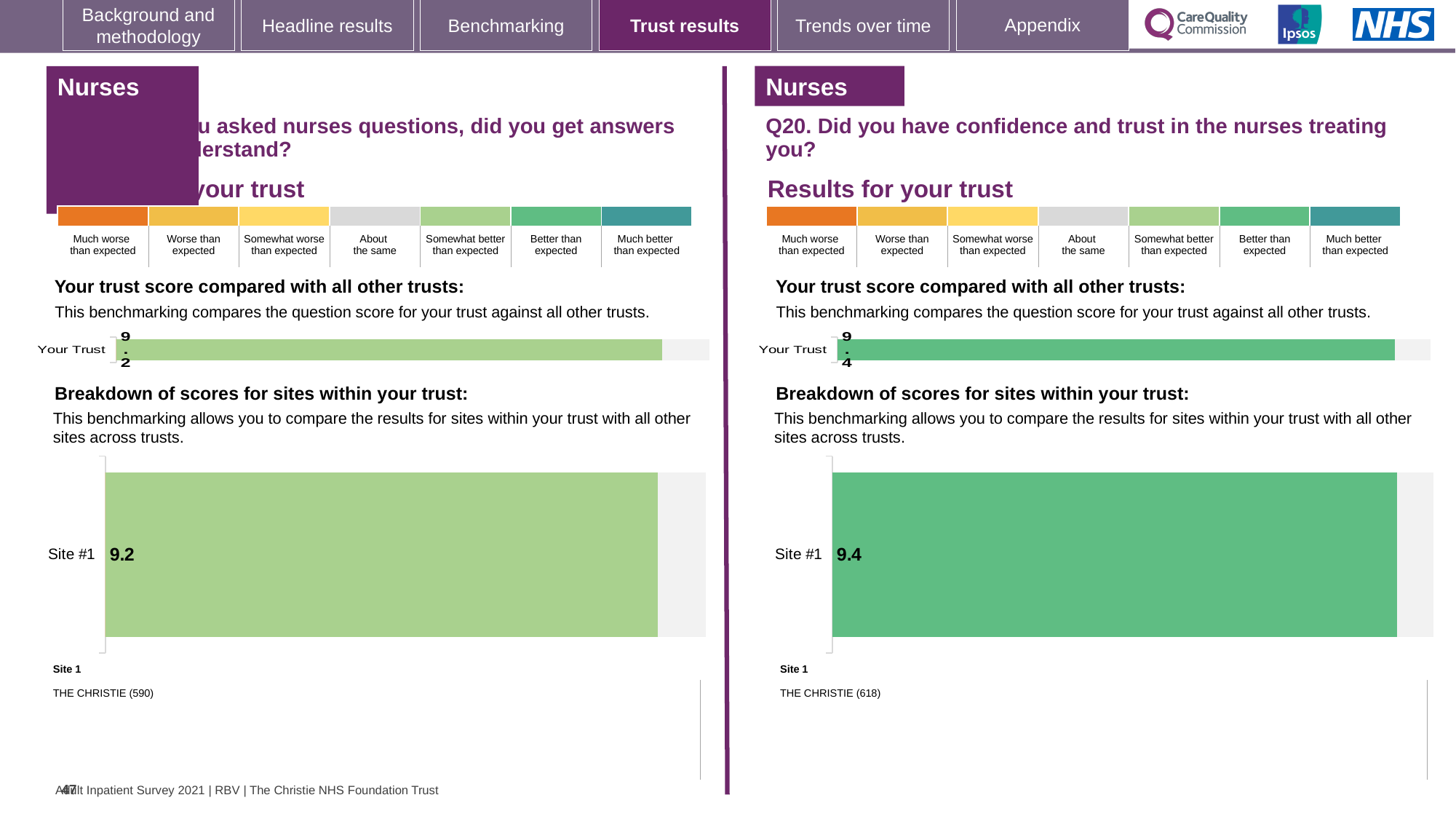
On the right-hand chart for Q20 (confidence and trust in the nurses treating you), what is the score shown for Your Trust? 9.4 What type of chart is used to show the Your Trust score on the left-hand chart? Bar chart Which is larger: the Site #1 score on the left-hand chart or the Site #1 score on the right-hand Q20 chart? The right-hand Q20 chart (9.4) How many sites are shown in the left-hand site breakdown chart? 1 How many sites are shown in the right-hand Q20 site breakdown chart? 1 Which site name is listed under Site 1 on the left-hand chart? THE CHRISTIE (590) On the right-hand site breakdown chart for Q20, what is the score for Site #1? 9.4 What is the difference between the Site #1 score on the right-hand Q20 chart and the Site #1 score on the left-hand chart? 0.2 On the left-hand site breakdown chart, what is the score for Site #1? 9.2 Which site name is listed under Site 1 on the right-hand Q20 chart? THE CHRISTIE (618) On the left-hand chart, what is the score shown for Your Trust? 9.2 What type of chart is used to show the Site #1 score on the right-hand Q20 chart? Bar chart